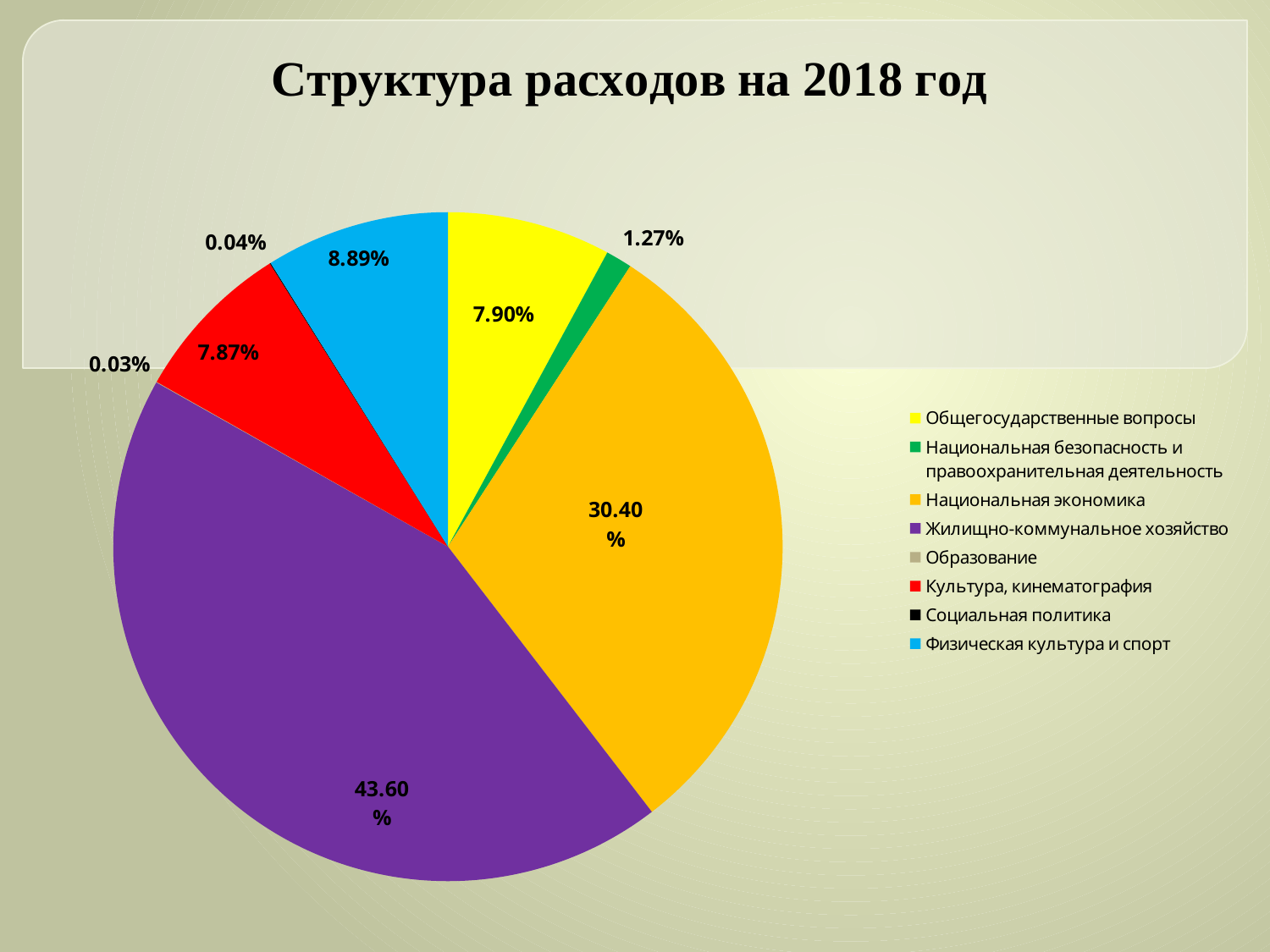
How many categories does the legend of the pie chart list? 8 Which category has the largest share of the pie? Жилищно-коммунальное хозяйство What is the value shown for Жилищно-коммунальное хозяйство? 43.60% What is the value shown for Физическая культура и спорт? 8.89% What share of the pie does Национальная экономика have? 30.40% What is the difference between the shares of Жилищно-коммунальное хозяйство and Национальная экономика? 13.20% What is the value shown for Национальная безопасность и правоохранительная деятельность? 1.27% What kind of chart is shown on the slide? pie chart What is the value shown for Общегосударственные вопросы? 7.90% What is the title of the chart? Структура расходов на 2018 год Which is larger: the share of Физическая культура и спорт or the share of Общегосударственные вопросы? Физическая культура и спорт What is the value shown for Культура, кинематография? 7.87%